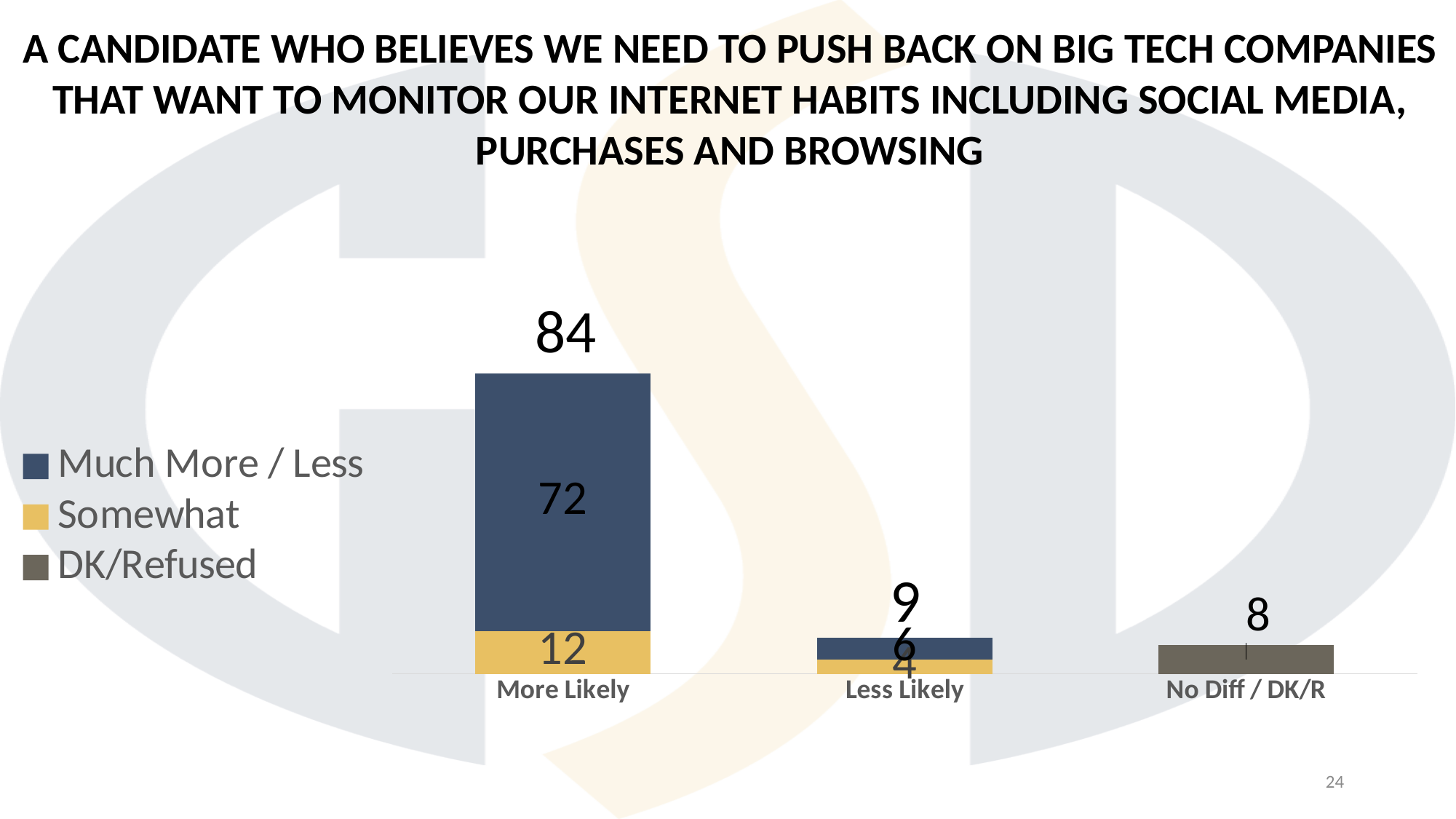
What is the Somewhat value for Less Likely? 4 Which legend entry is shown in yellow? Somewhat What is the DK/Refused value for No Diff / DK/R? 8 What is the Somewhat value for More Likely? 12 Which category has the tallest bar? More Likely What total is printed above the More Likely bar? 84 How many series does the legend list? 3 How many categories are shown on the x axis? 3 What is the Much More / Less value for Less Likely? 6 What type of chart is shown on the slide? stacked bar chart What is the Much More / Less value for More Likely? 72 What is the difference between the Much More / Less values for More Likely and Less Likely? 66